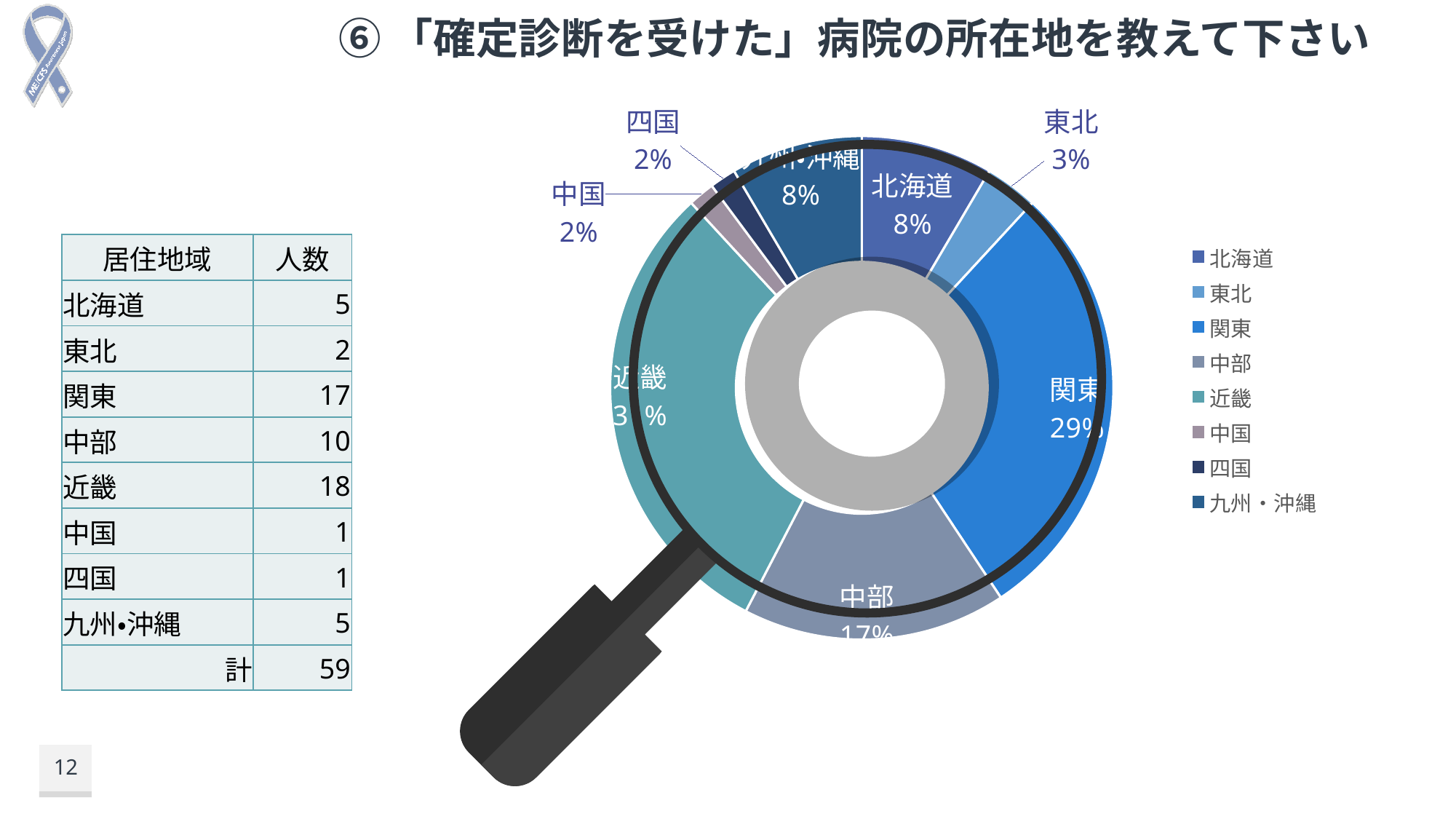
What is the difference in percentage points between 関東 and 中部? 12 percentage points What percentage does the chart show for 東北? 3% What percentage does the chart show for 北海道? 8% What percentage does the chart show for 四国? 2% What kind of chart is shown on the slide? Pie (doughnut) chart How many entries does the chart legend list? 8 What percentage does the chart show for 中部? 17% What percentage does the chart show for 九州・沖縄? 8% What percentage does the chart show for 関東? 29% How many regions (slices) does the chart show? 8 Which slice is larger, 北海道 or 東北? 北海道 Which slice is larger, 関東 or 中部? 関東